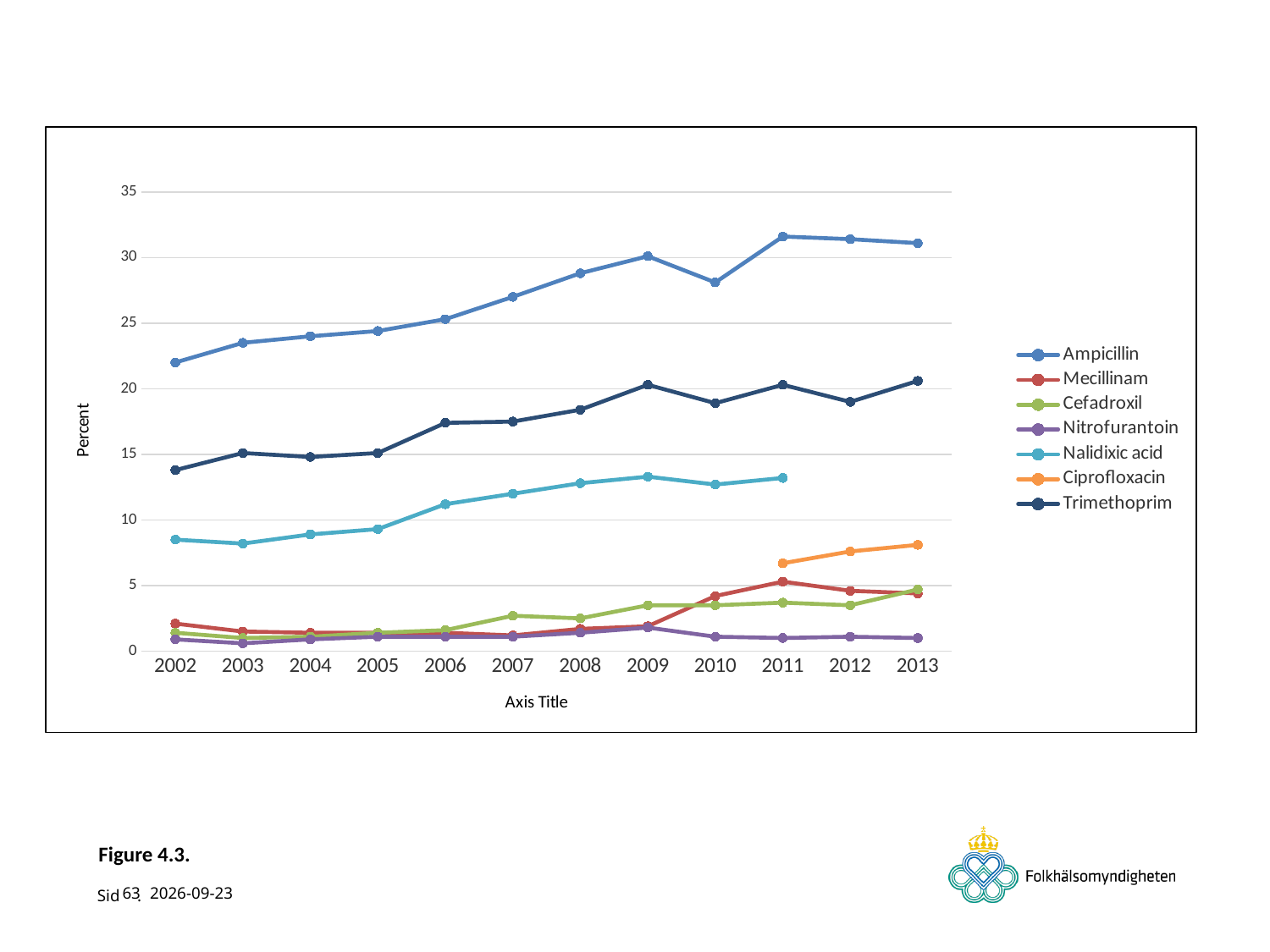
What is the label on the y axis? Percent How many years are shown along the x axis? 12 Does the Ampicillin line generally rise or fall from 2002 to 2013? rise Is the value for Ciprofloxacin in 2013 greater or less than 10? less Is the value for Nalidixic acid in 2006 greater or less than 10? greater Is the value for Ampicillin in 2011 greater or less than 30? greater How many series does the legend list? 7 Which series has the lowest value in 2013? Nitrofurantoin In 2009, which is larger: Ampicillin or Trimethoprim? Ampicillin What kind of chart is shown on the slide? line chart Which series has the highest values across all years? Ampicillin